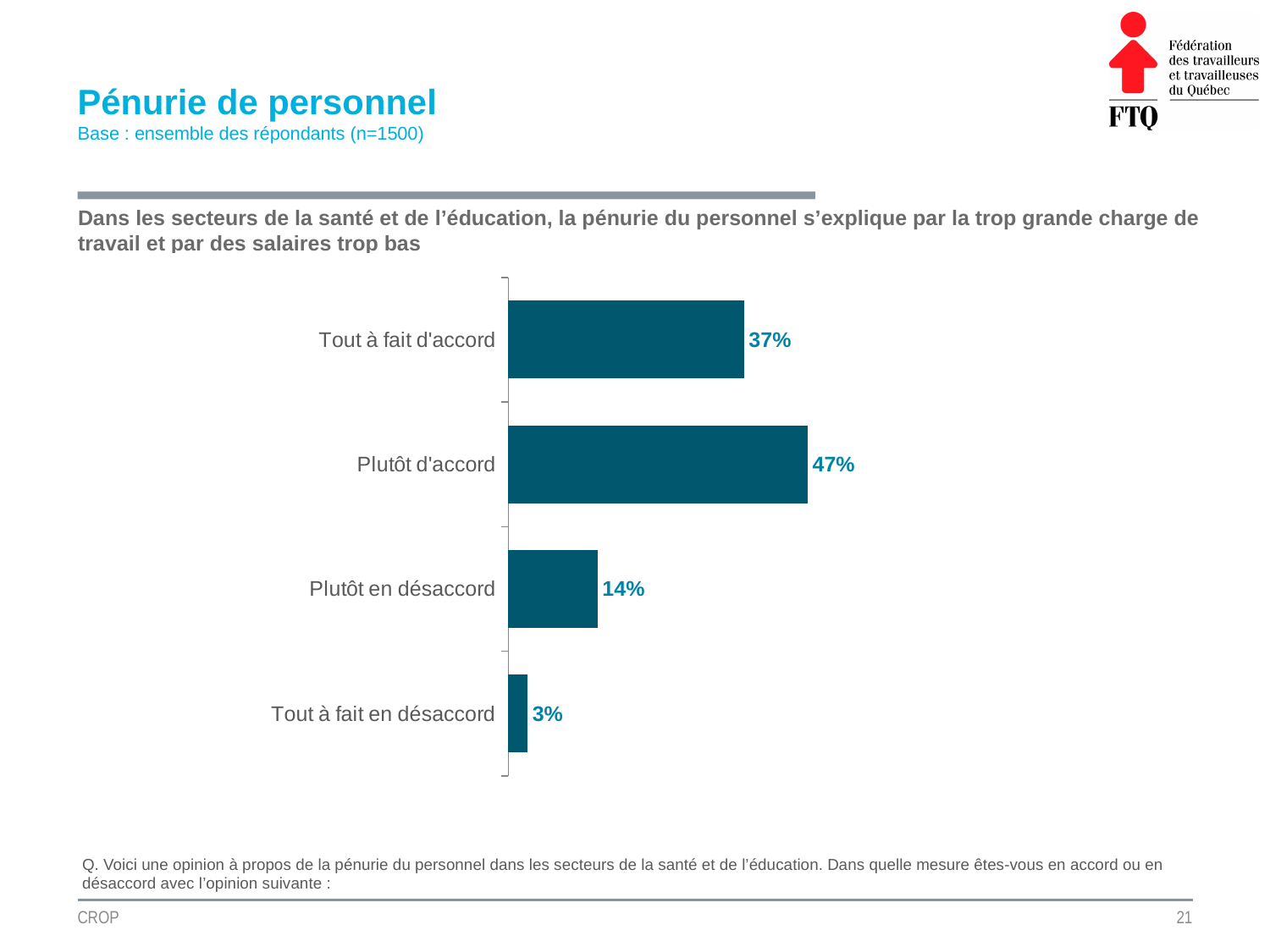
Which category has the highest value? Plutôt d'accord How many categories are shown in the chart? 4 Which category has the lowest value? Tout à fait en désaccord What is the combined value of "Tout à fait d'accord" and "Plutôt d'accord"? 84% Which is larger, "Tout à fait d'accord" or "Plutôt en désaccord"? Tout à fait d'accord What is the value for "Plutôt en désaccord"? 14% What is the value for "Tout à fait d'accord"? 37% What is the value for "Plutôt d'accord"? 47% What is the difference between "Plutôt en désaccord" and "Tout à fait en désaccord"? 11% What kind of chart is shown on the slide? Bar chart What is the difference between "Plutôt d'accord" and "Tout à fait d'accord"? 10% What is the value for "Tout à fait en désaccord"? 3%